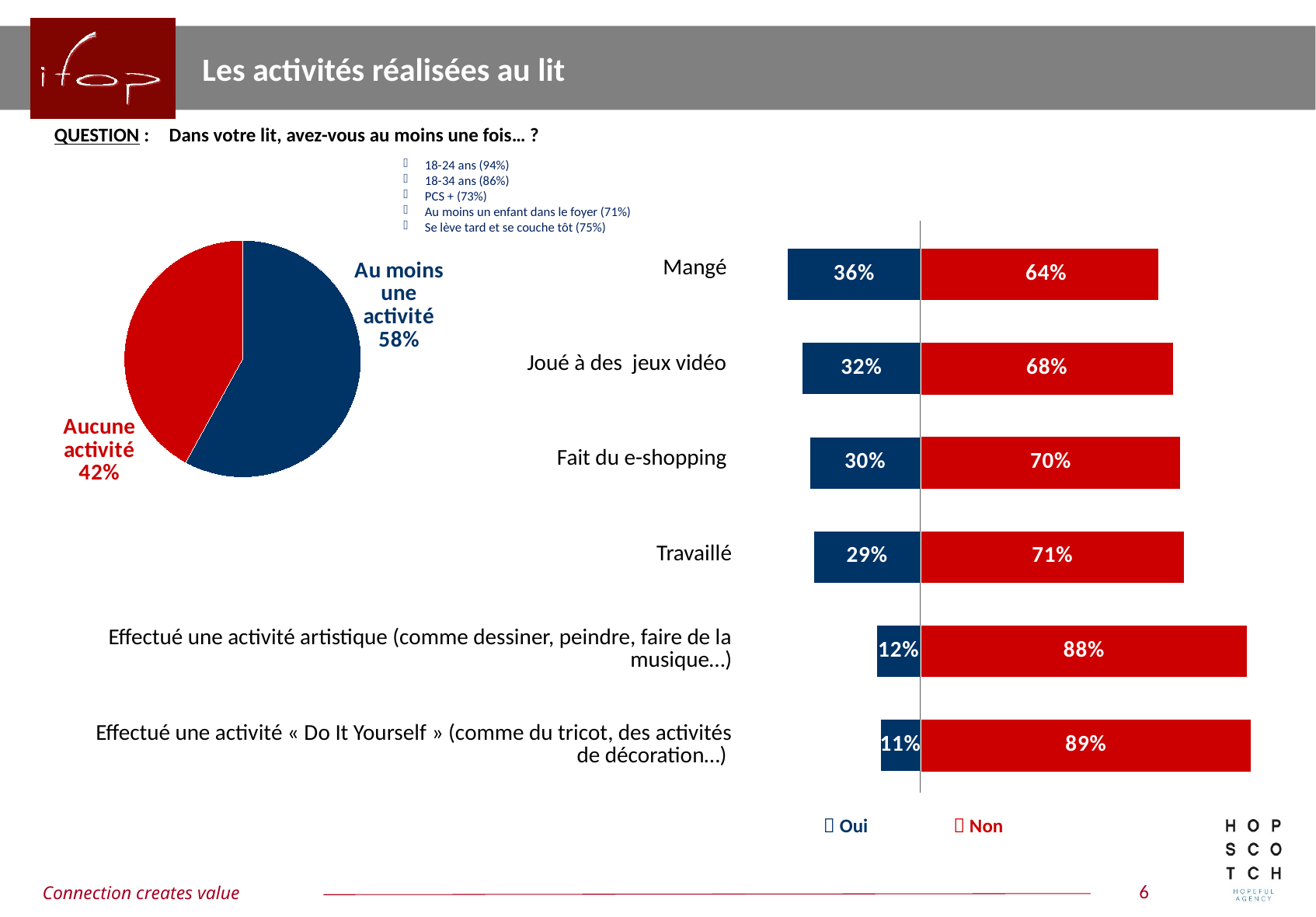
In the bar chart on the right, what is the difference between the 'Oui' values for 'Mangé' and 'Joué à des jeux vidéo'? 4% In the bar chart on the right, what is the 'Oui' value for 'Travaillé'? 29% In the bar chart on the right, what is the 'Oui' value for 'Mangé'? 36% In the bar chart on the right, which activity has the highest 'Oui' value? Mangé In the pie chart on the left, what share is labelled 'Au moins une activité'? 58% In the bar chart on the right, which is larger: the 'Oui' value for 'Fait du e-shopping' or for 'Travaillé'? Fait du e-shopping In the pie chart on the left, what share is labelled 'Aucune activité'? 42% How many series does the legend of the bar chart on the right list? 2 In the bar chart on the right, which activity has the lowest 'Oui' value? Effectué une activité « Do It Yourself » (comme du tricot, des activités de décoration…) How many activities are listed in the bar chart on the right? 6 What type of chart is shown on the left of the slide? Pie chart In the bar chart on the right, what is the 'Non' value for 'Fait du e-shopping'? 70%